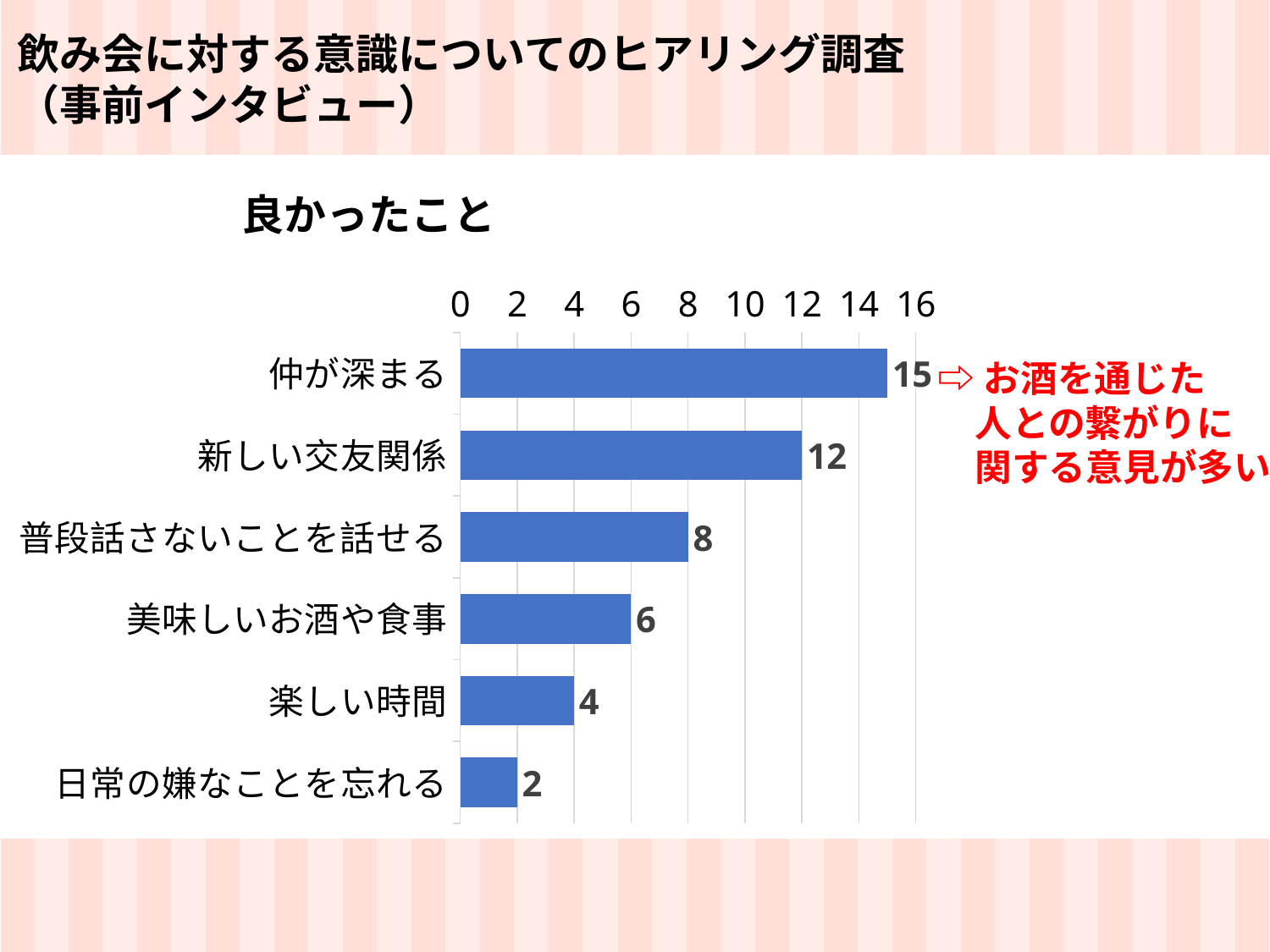
How many categories are shown in the chart? 6 What is the title of the chart? 良かったこと What is the value for 美味しいお酒や食事? 6 What is the difference between the values for 仲が深まる and 新しい交友関係? 3 What is the difference between the values for 普段話さないことを話せる and 楽しい時間? 4 Which category has the highest value? 仲が深まる Which category has the lowest value? 日常の嫌なことを忘れる What is the value for 新しい交友関係? 12 What kind of chart is shown on the slide? bar chart What is the value for 仲が深まる? 15 What is the value for 日常の嫌なことを忘れる? 2 Which is larger, the value for 美味しいお酒や食事 or the value for 楽しい時間? 美味しいお酒や食事